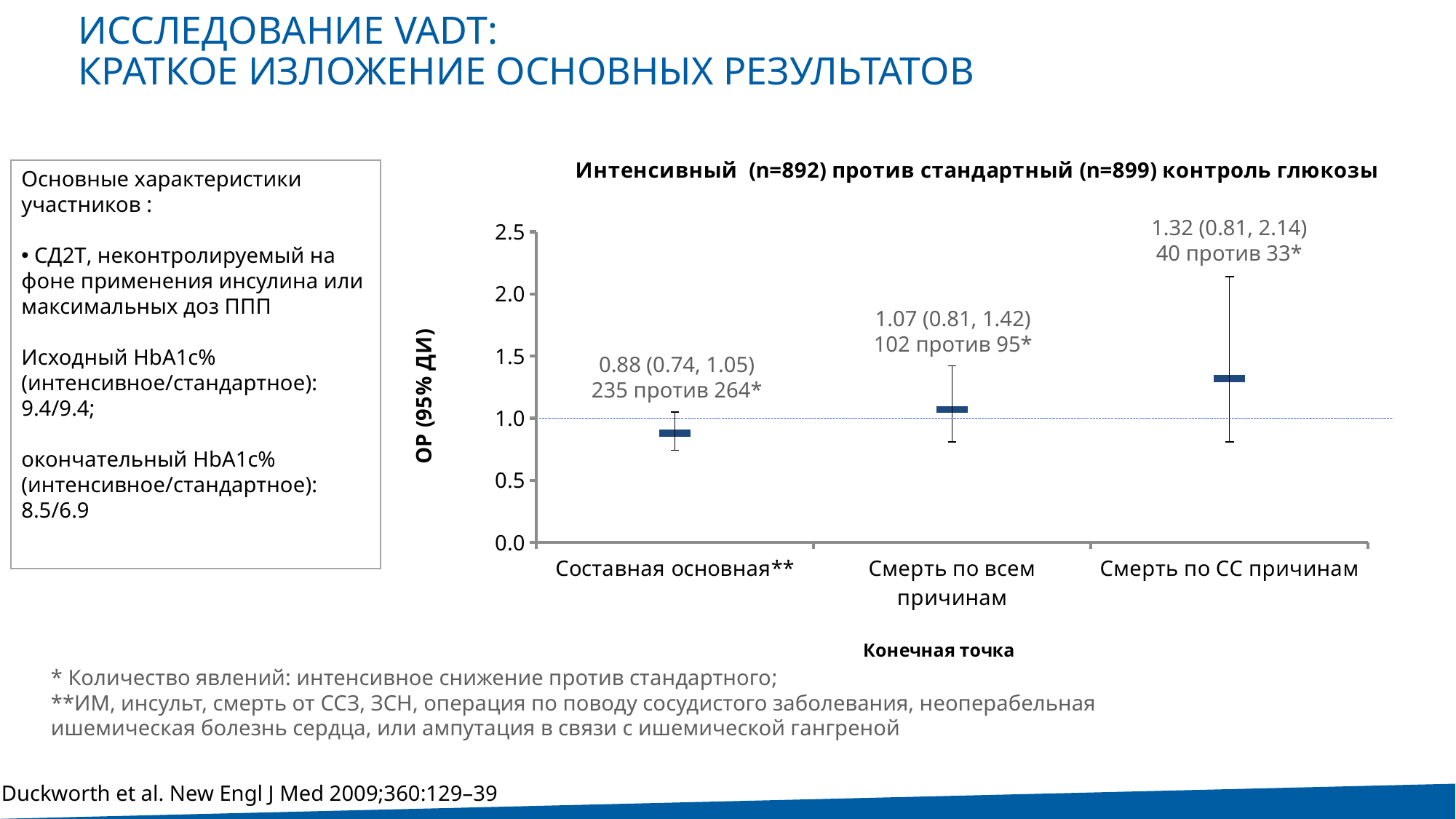
What is the 95% confidence interval printed for 'Смерть по всем причинам'? (0.81, 1.42) How many endpoints are plotted on the x axis? 3 Which endpoint has the highest hazard ratio? Смерть по СС причинам What is the difference between the hazard ratios for 'Смерть по СС причинам' and 'Составная основная**'? 0.44 How many events are listed for 'Составная основная**' (intensive vs standard)? 235 против 264 Is the hazard ratio for 'Смерть по всем причинам' larger or smaller than that for 'Составная основная**'? larger What is the label of the y axis? ОР (95% ДИ) What is the hazard ratio and 95% CI printed for 'Смерть по СС причинам'? 1.32 (0.81, 2.14) Which endpoint has the lowest hazard ratio? Составная основная** Is the hazard ratio for 'Составная основная**' greater or less than 1.0? less How many events are listed for 'Смерть по СС причинам' (intensive vs standard)? 40 против 33 What is the hazard ratio (ОР) shown for the endpoint 'Составная основная**'? 0.88